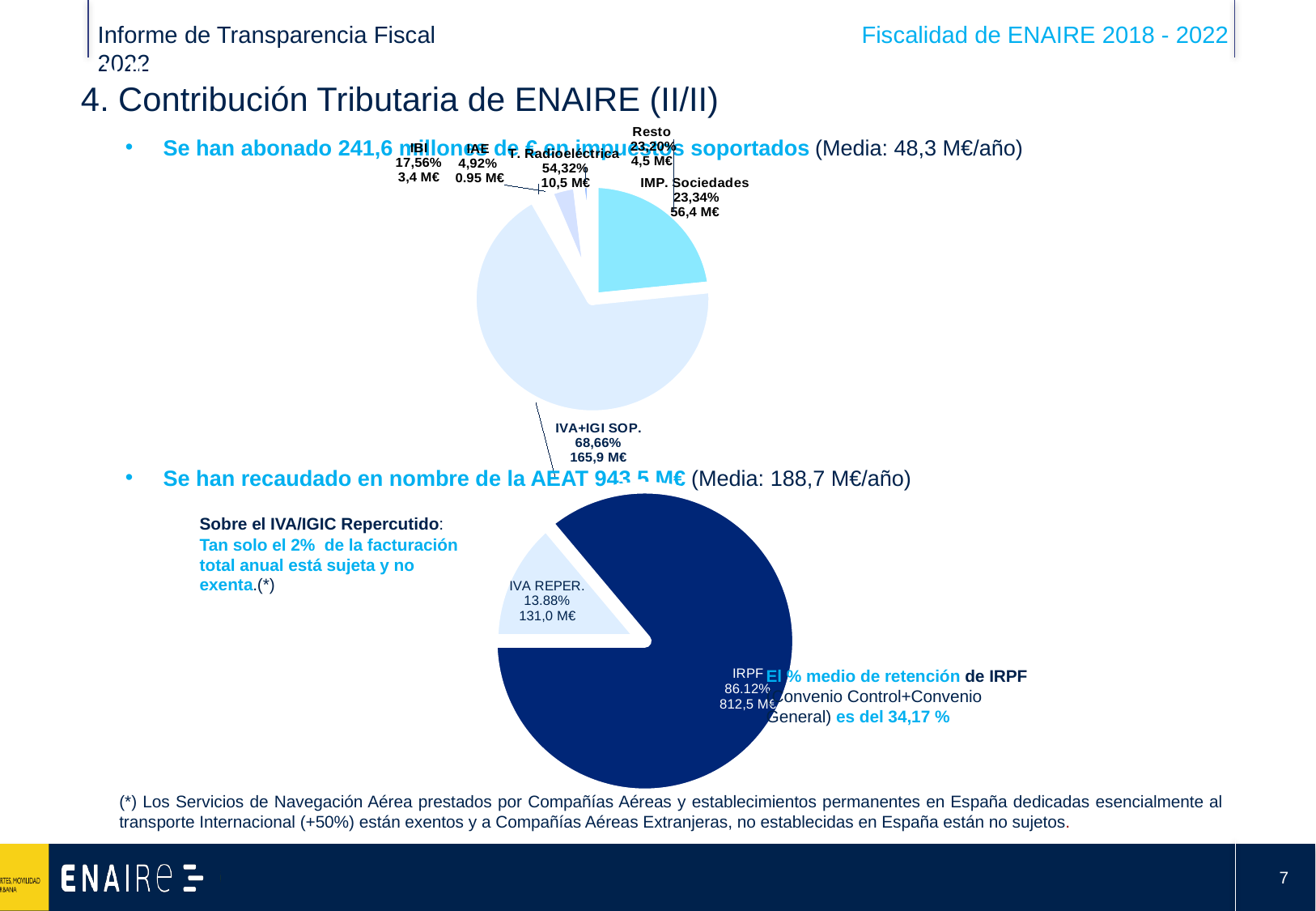
In the top pie chart, which category has the smallest amount? IAE In the bottom pie chart, what percentage share does IVA REPER. have? 13.88% In the bottom pie chart, what is the amount in M€ for IRPF? 812,5 M€ In the top pie chart, what is the difference in M€ between IVA+IGI SOP. and IMP. Sociedades? 109,5 M€ In the top pie chart, what percentage share does IVA+IGI SOP. have? 68,66% In the top pie chart, what is the amount in M€ for IMP. Sociedades? 56,4 M€ In the top pie chart, which is larger in M€: IBI or Resto? Resto In the top pie chart, how many categories are shown? 6 In the bottom pie chart, what is the difference in M€ between IRPF and IVA REPER.? 681,5 M€ In the bottom pie chart, how many slices are there? 2 What kind of chart is the top chart on the slide? pie chart In the top pie chart, which category has the largest amount? IVA+IGI SOP.